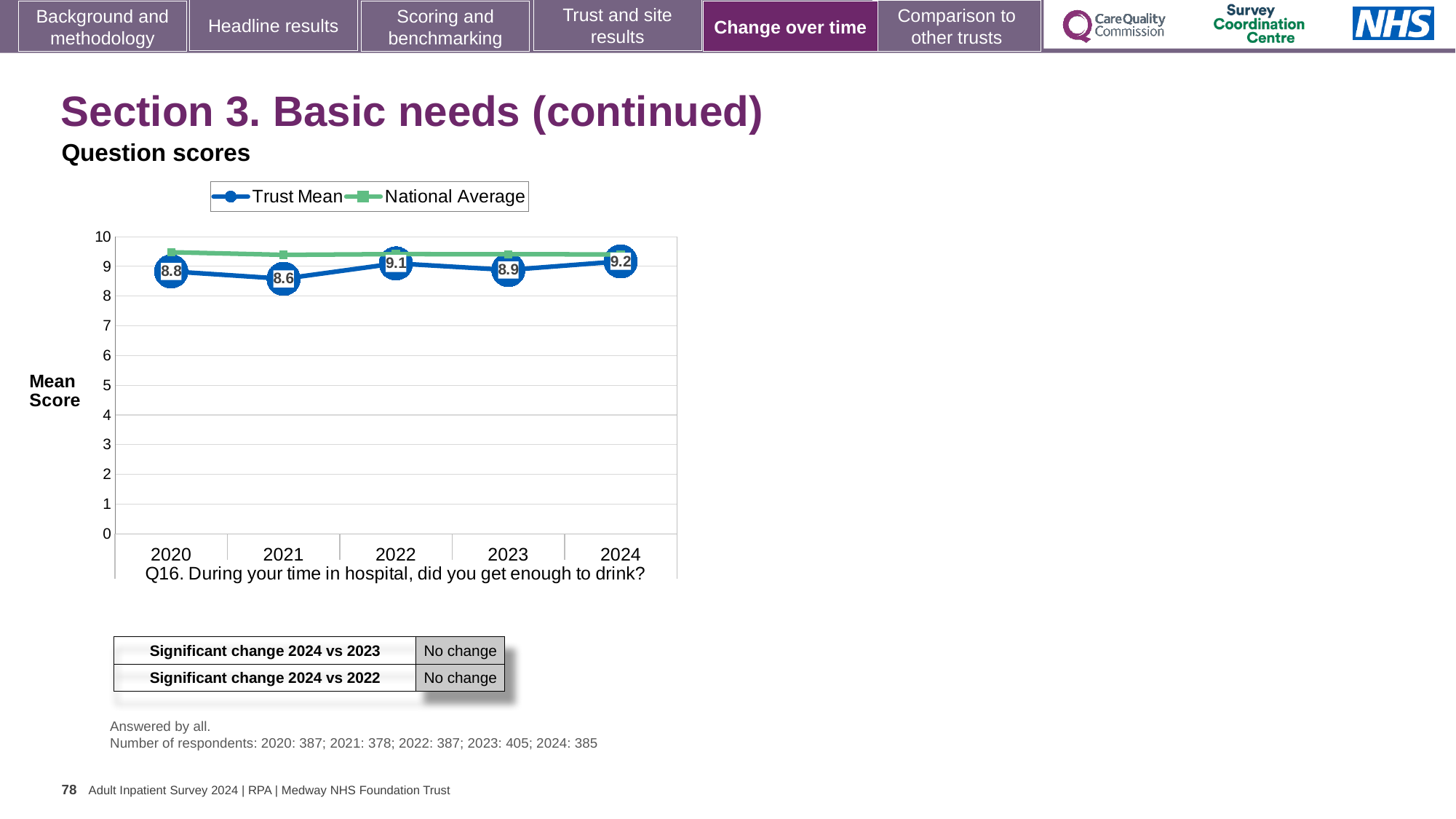
In which year is the Trust Mean score highest? 2024 What is the Trust Mean score for 2021? 8.6 How many series does the legend list? 2 What is the difference between the Trust Mean score in 2024 and in 2021? 0.6 Is the National Average value for 2020 greater or less than 9? greater What is the Trust Mean score for 2024? 9.2 What is the Trust Mean score for 2020? 8.8 In which year is the Trust Mean score lowest? 2021 Which is larger, the Trust Mean score for 2022 or for 2023? 2022 Does the Trust Mean score rise or fall from 2023 to 2024? Rise How many years are plotted on the x axis? 5 What kind of chart is shown on the slide? Line chart